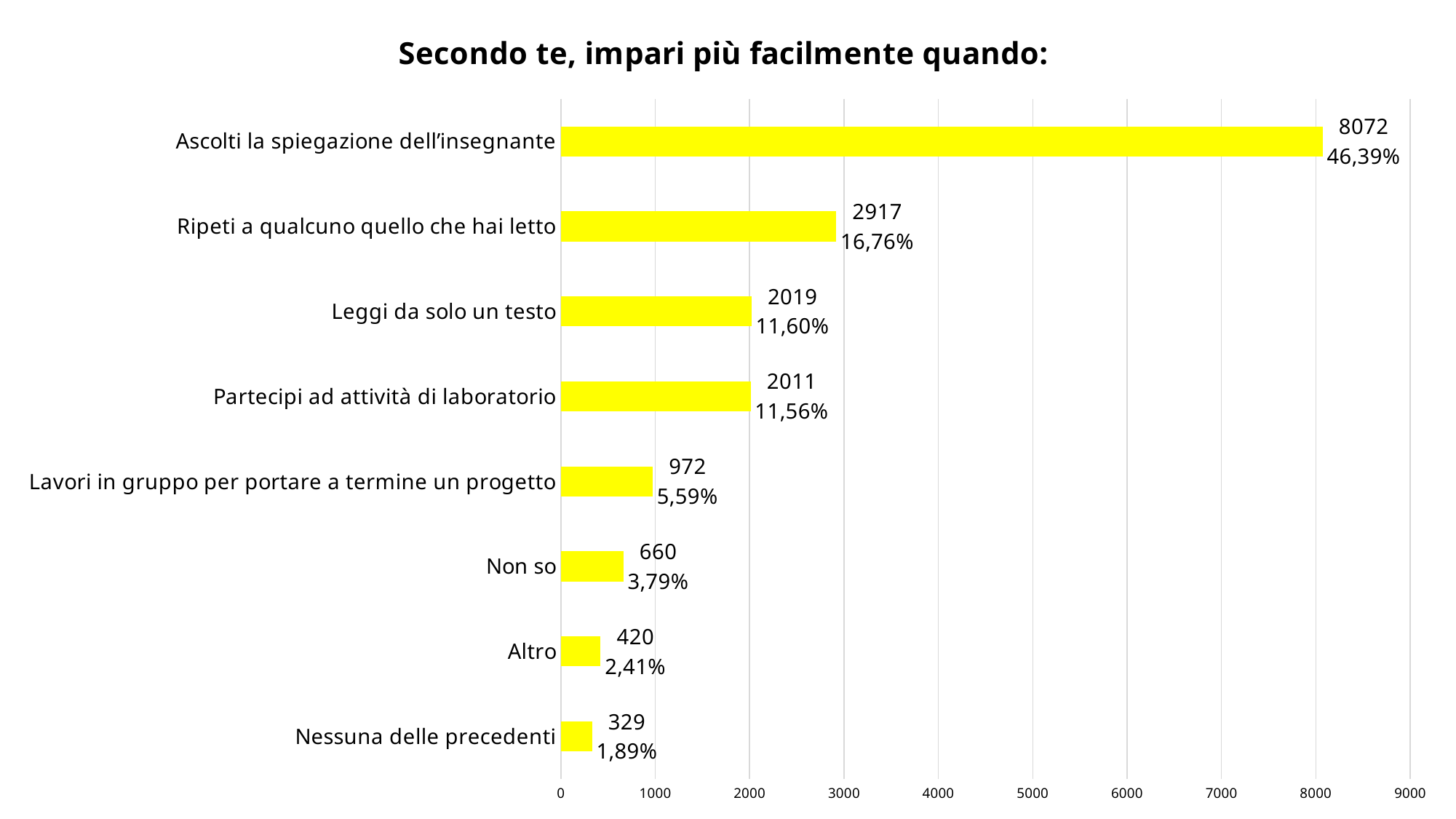
How many categories are shown in the chart? 8 Which is larger: the value for "Lavori in gruppo per portare a termine un progetto" or the value for "Altro"? Lavori in gruppo per portare a termine un progetto Is the value for "Ripeti a qualcuno quello che hai letto" greater or less than 2000? greater What is the difference between the values for "Ripeti a qualcuno quello che hai letto" and "Leggi da solo un testo"? 898 What colour are the bars in the chart? yellow What is the title of the chart? Secondo te, impari più facilmente quando: Which category has the lowest value? Nessuna delle precedenti What is the value for "Non so"? 660 What kind of chart is shown on the slide? bar chart What percentage is shown for "Ripeti a qualcuno quello che hai letto"? 16,76% What is the value for "Ascolti la spiegazione dell'insegnante"? 8072 Which category has the highest value? Ascolti la spiegazione dell'insegnante